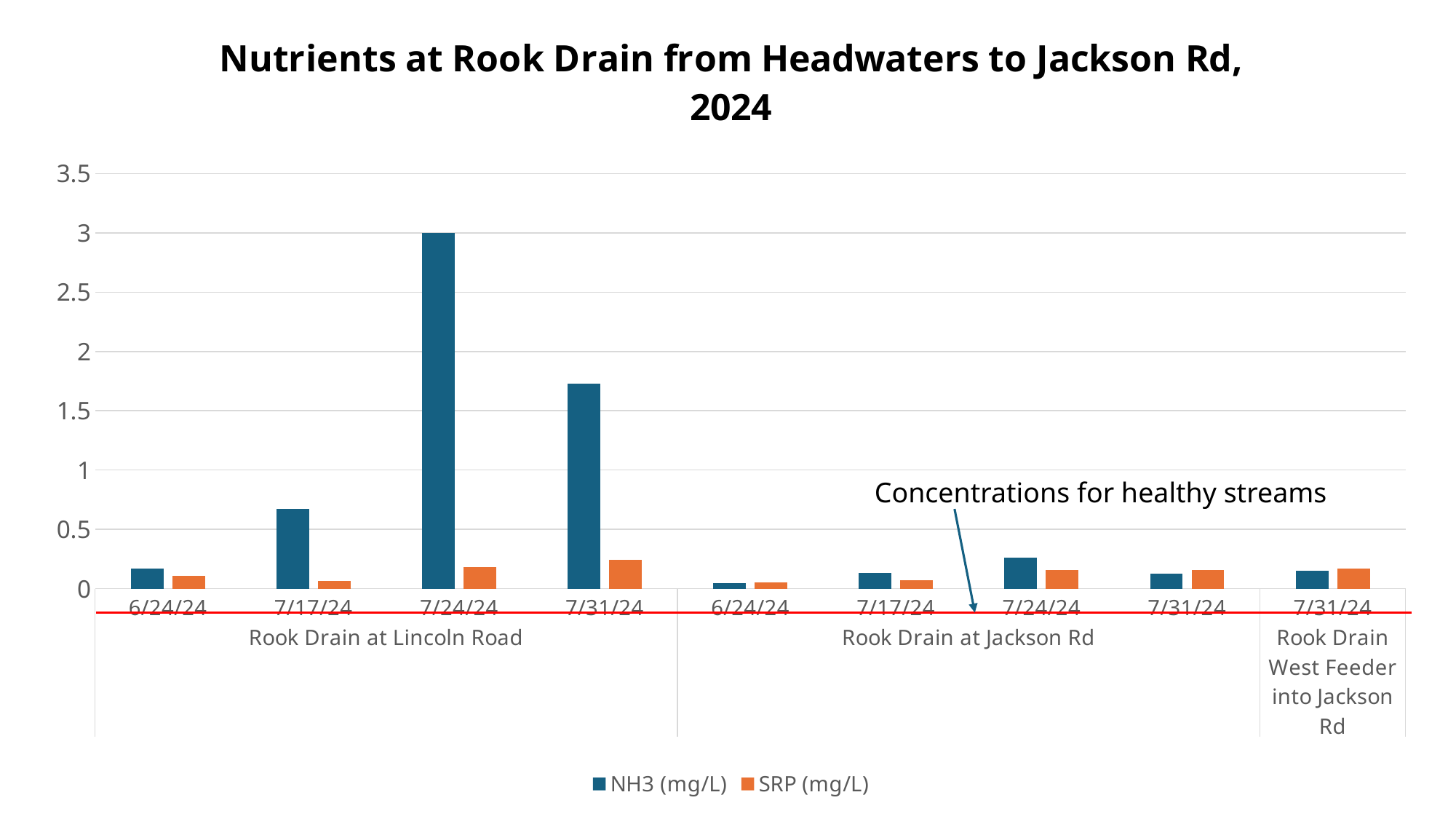
Is the NH3 (mg/L) value for 7/17/24 at Rook Drain at Lincoln Road greater or less than 1? less What kind of chart is shown on the slide? bar chart Is the NH3 (mg/L) value for 7/24/24 at Rook Drain at Lincoln Road greater or less than 2.5? greater At Rook Drain at Lincoln Road on 7/31/24, which is larger, NH3 (mg/L) or SRP (mg/L)? NH3 (mg/L) What are the two series named in the legend? NH3 (mg/L) and SRP (mg/L) At Rook Drain at Jackson Rd on 7/24/24, which is larger, NH3 (mg/L) or SRP (mg/L)? NH3 (mg/L) Does the NH3 (mg/L) value at Rook Drain at Lincoln Road rise or fall from 6/24/24 to 7/24/24? rise How many sampling sites are labelled along the x axis? 3 What does the annotation pointing to the red line say? Concentrations for healthy streams Which date and site has the highest NH3 (mg/L) bar? 7/24/24 at Rook Drain at Lincoln Road How many series does the legend list? 2 Is the NH3 (mg/L) value for 7/31/24 at Rook Drain at Lincoln Road greater or less than 1.5? greater